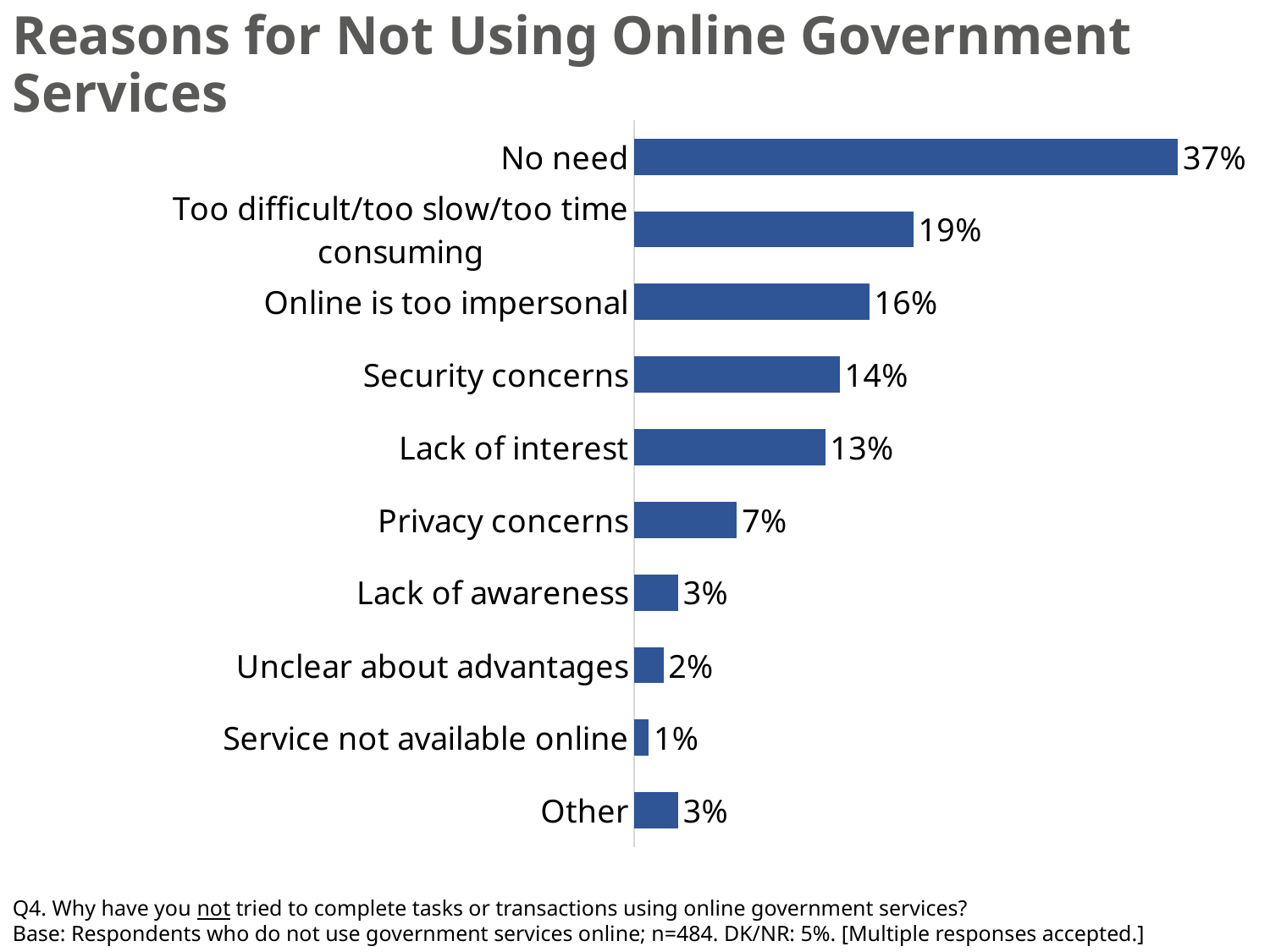
What is the difference between "Online is too impersonal" and "Privacy concerns"? 9% What percentage of respondents cited "No need" as a reason for not using online government services? 37% What percentage is shown for "Service not available online"? 1% What is the title of the chart on the slide? Reasons for Not Using Online Government Services What kind of chart is shown on the slide? Bar chart Which is larger: "Security concerns" or "Lack of interest"? Security concerns Which reason has the lowest percentage? Service not available online What is the value shown for "Security concerns"? 14% How many reasons (categories) are shown in the chart? 10 Which reason has the highest percentage? No need What is the difference between the percentages for "No need" and "Too difficult/too slow/too time consuming"? 18% Which is larger: "Privacy concerns" or "Lack of awareness"? Privacy concerns